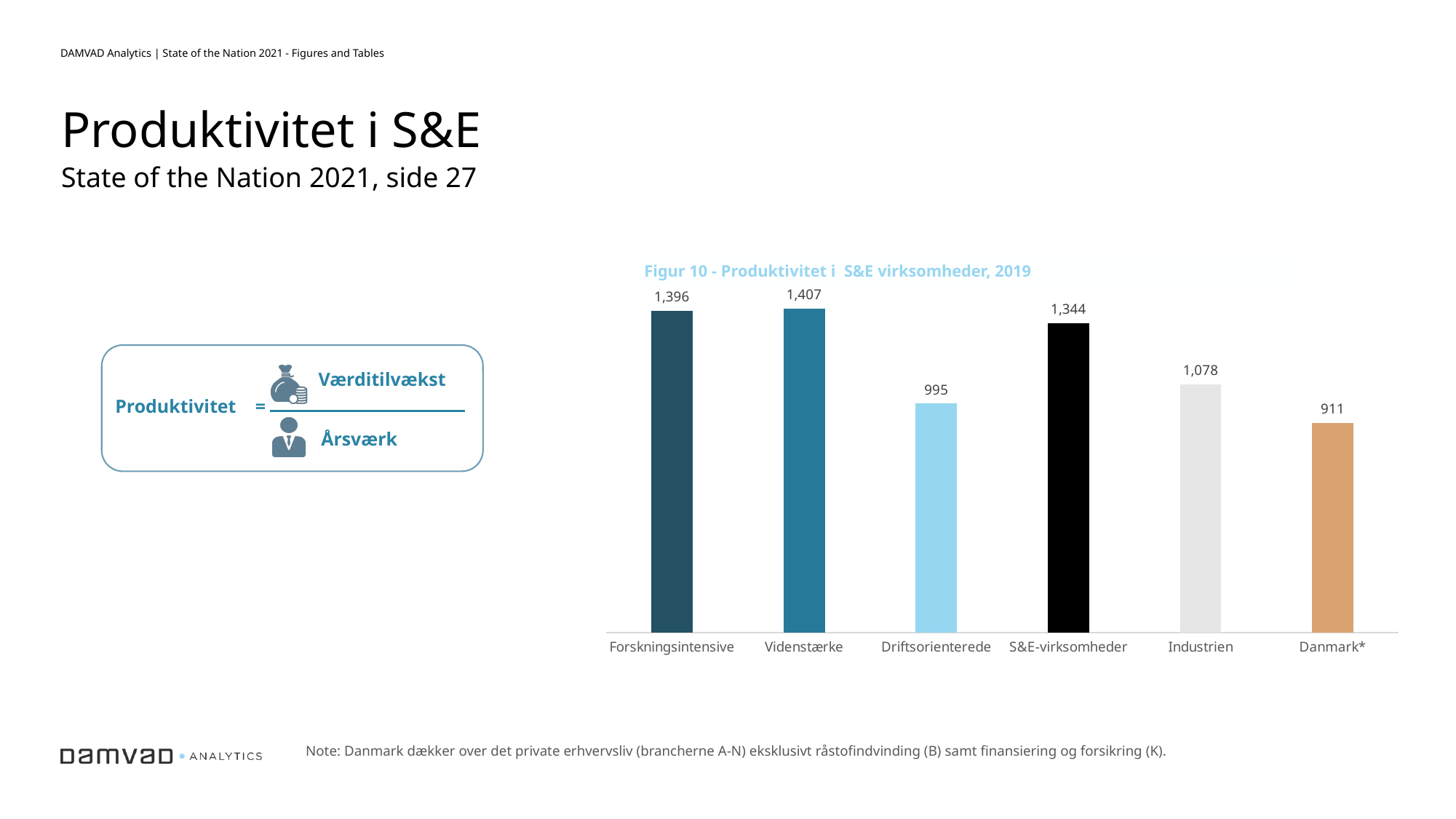
What is the difference between the values for S&E-virksomheder and Danmark*? 433 What is the value for Driftsorienterede? 995 Which category has the lowest value? Danmark* What is the value for Videnstærke? 1,407 What is the value for S&E-virksomheder? 1,344 What is the value for Danmark*? 911 What is the title of the chart? Figur 10 - Produktivitet i S&E virksomheder, 2019 Which is larger, the value for Industrien or the value for Driftsorienterede? Industrien What is the value for Industrien? 1,078 What is the value for Forskningsintensive? 1,396 What kind of chart is shown? Bar chart How many categories are shown in the chart? 6